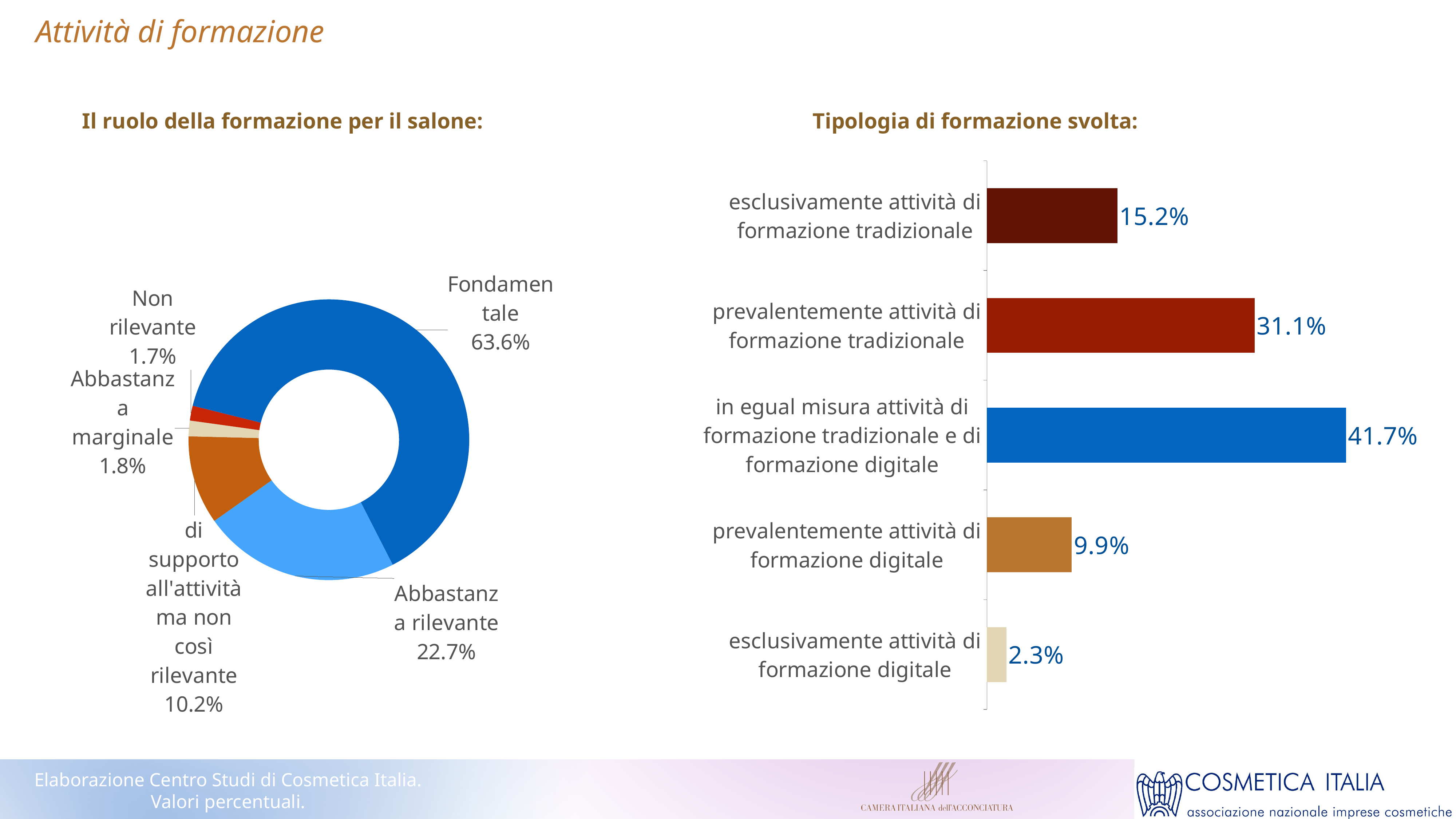
In the 'Il ruolo della formazione per il salone' chart, what share is labelled 'Fondamentale'? 63.6% In the 'Il ruolo della formazione per il salone' chart, what is the value for 'Abbastanza rilevante'? 22.7% In the 'Il ruolo della formazione per il salone' chart, how many categories are shown? 5 What kind of chart is 'Tipologia di formazione svolta'? Bar chart In the 'Tipologia di formazione svolta' chart, what is the difference between 'in egual misura attività di formazione tradizionale e di formazione digitale' and 'prevalentemente attività di formazione tradizionale'? 10.6% In the 'Il ruolo della formazione per il salone' chart, which category has the smallest share? Non rilevante In the 'Il ruolo della formazione per il salone' chart, what is the difference between 'Fondamentale' and 'Abbastanza rilevante'? 40.9% In the 'Tipologia di formazione svolta' chart, what is the value for 'prevalentemente attività di formazione tradizionale'? 31.1% In the 'Tipologia di formazione svolta' chart, which category has the lowest value? esclusivamente attività di formazione digitale What kind of chart is 'Il ruolo della formazione per il salone'? Doughnut chart In the 'Tipologia di formazione svolta' chart, which category has the highest value? in egual misura attività di formazione tradizionale e di formazione digitale In the 'Tipologia di formazione svolta' chart, which is larger: 'esclusivamente attività di formazione tradizionale' or 'prevalentemente attività di formazione digitale'? esclusivamente attività di formazione tradizionale